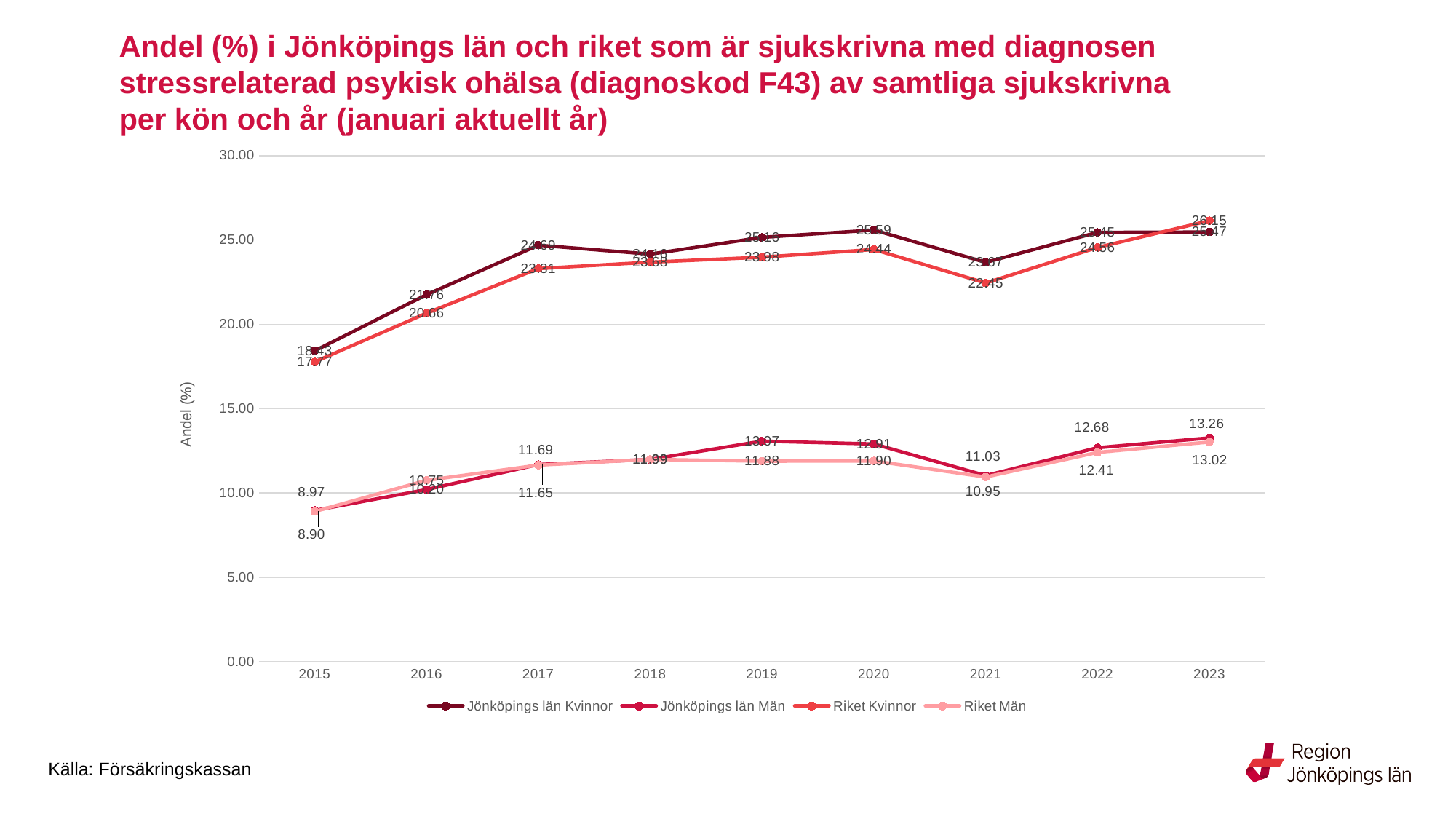
What is the value for Jönköpings län Män in 2022? 12.68 How many series does the legend list? 4 In which year is the value for Riket Kvinnor highest? 2023 What is the difference between Jönköpings län Män and Riket Män in 2023? 0.24 What is the value for Riket Kvinnor in 2021? 22.45 By how much did the value for Riket Kvinnor increase from 2022 to 2023? 1.59 In which year is the value for Riket Män lowest? 2015 What kind of chart is shown on the slide? Line chart Which is larger for Riket Kvinnor: the value in 2020 or the value in 2021? 2020 What is the value for Riket Män in 2016? 10.75 What is the value for Riket Män in 2023? 13.02 How many years are shown on the x axis? 9